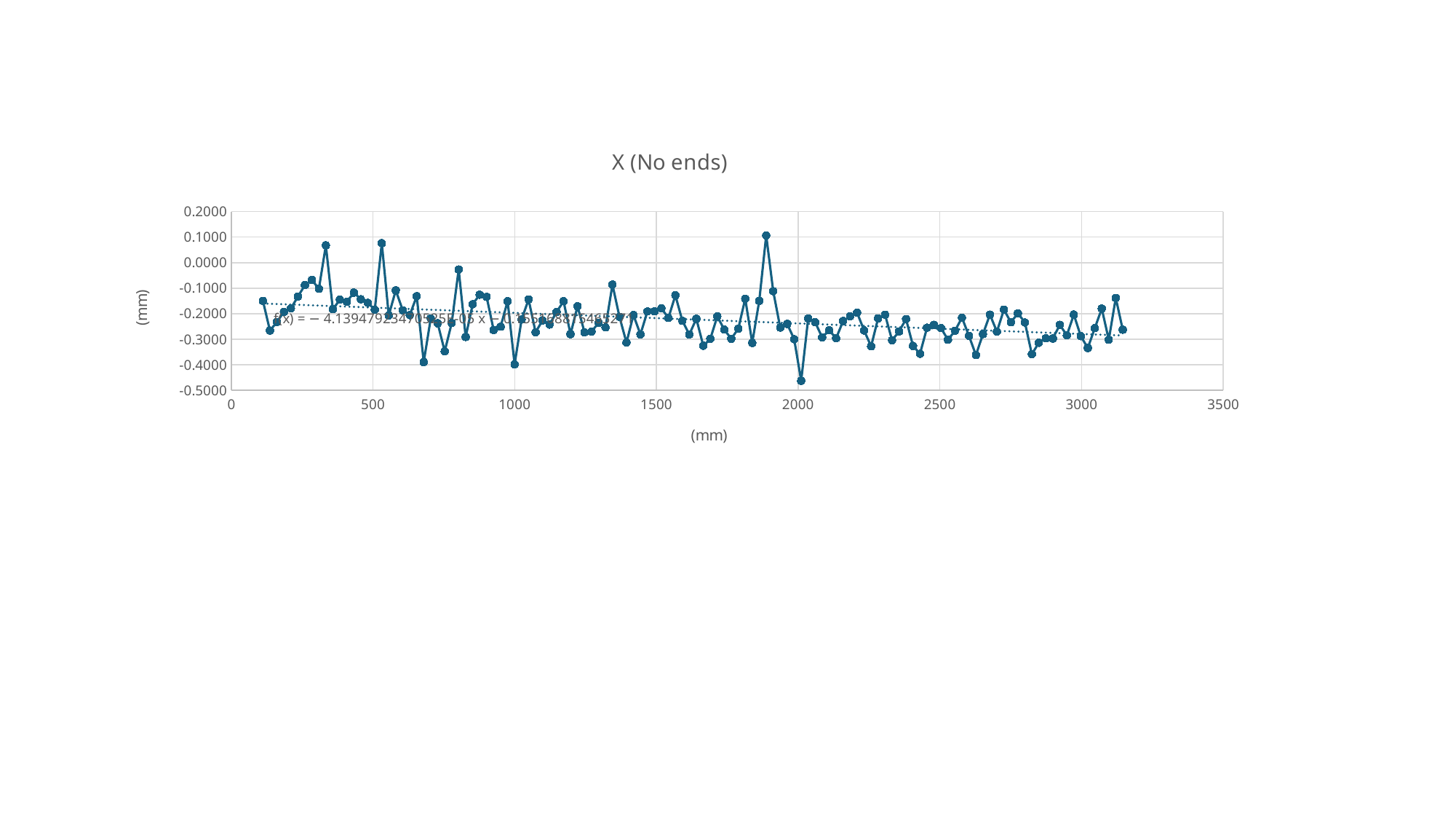
According to the dotted trendline, do the values generally rise or fall as x increases? fall Is the value of the point near x = 1000 greater or less than -0.3000? less Is the value of the point near x = 530 greater or less than 0.0000? greater What kind of chart is shown on the slide? line chart What is the title of the chart? X (No ends) Is the value of the point near x = 2010 greater or less than the value of the point near x = 1000? less Is the lowest point on the chart, near x = 2010, greater or less than -0.4000? less What is the label on the vertical axis of the chart? (mm)